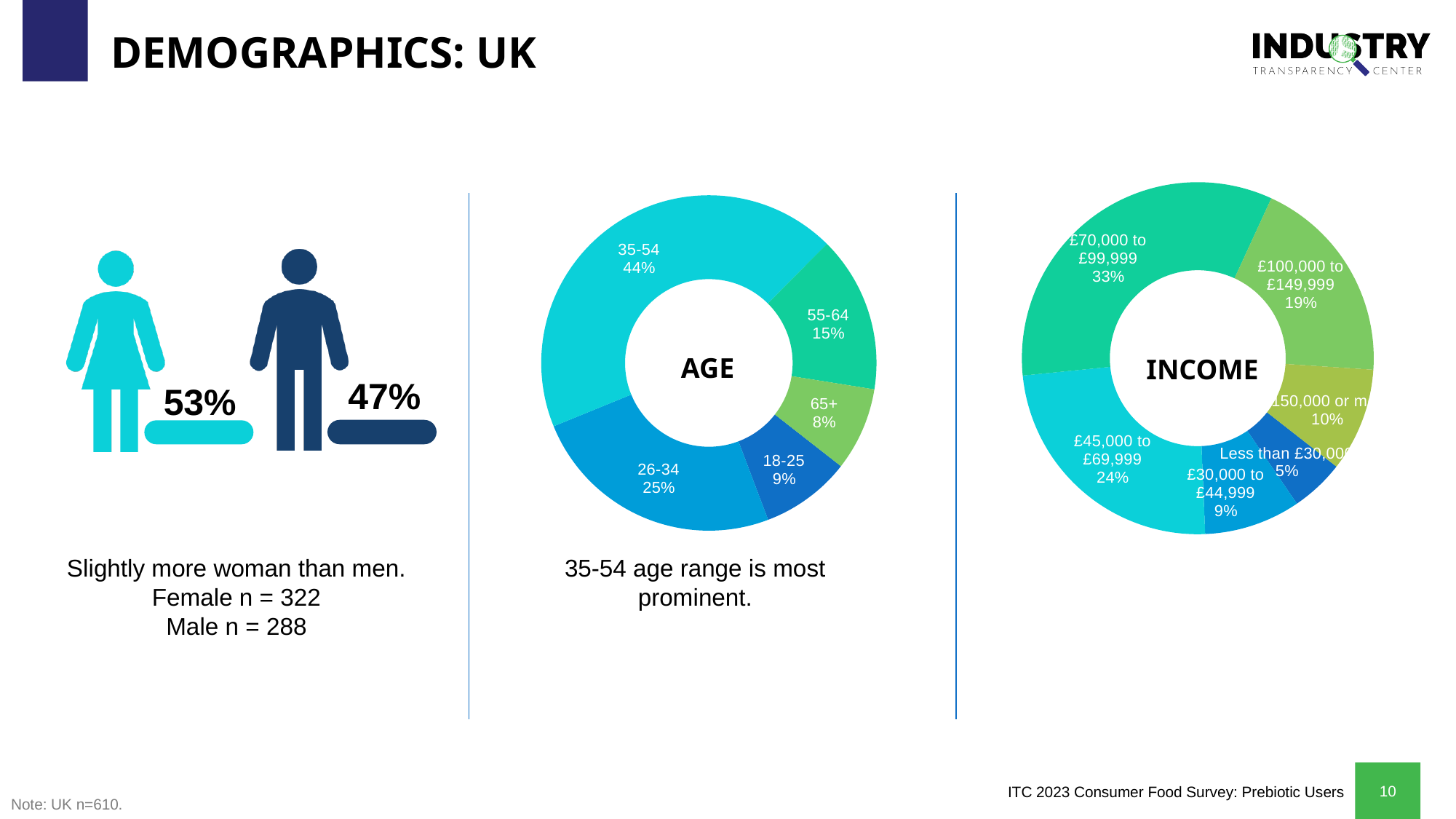
In the AGE chart, which age group has the smallest share? 65+ In the INCOME chart, what share of respondents earn £70,000 to £99,999? 33% In the AGE chart, what is the difference between the shares for 55-64 and 18-25? 6% In the INCOME chart, what share of respondents earn £45,000 to £69,999? 24% In the AGE chart, what share of respondents are aged 35-54? 44% In the AGE chart, which age group has the largest share? 35-54 In the INCOME chart, what is the difference between the shares for £100,000 to £149,999 and £30,000 to £44,999? 10% In the AGE chart, which is larger, the share for 26-34 or the share for 55-64? 26-34 What kind of chart is the AGE chart? pie chart (donut) In the INCOME chart, which income bracket has the largest share? £70,000 to £99,999 How many age groups are shown in the AGE chart? 5 In the AGE chart, what share of respondents are aged 26-34? 25%